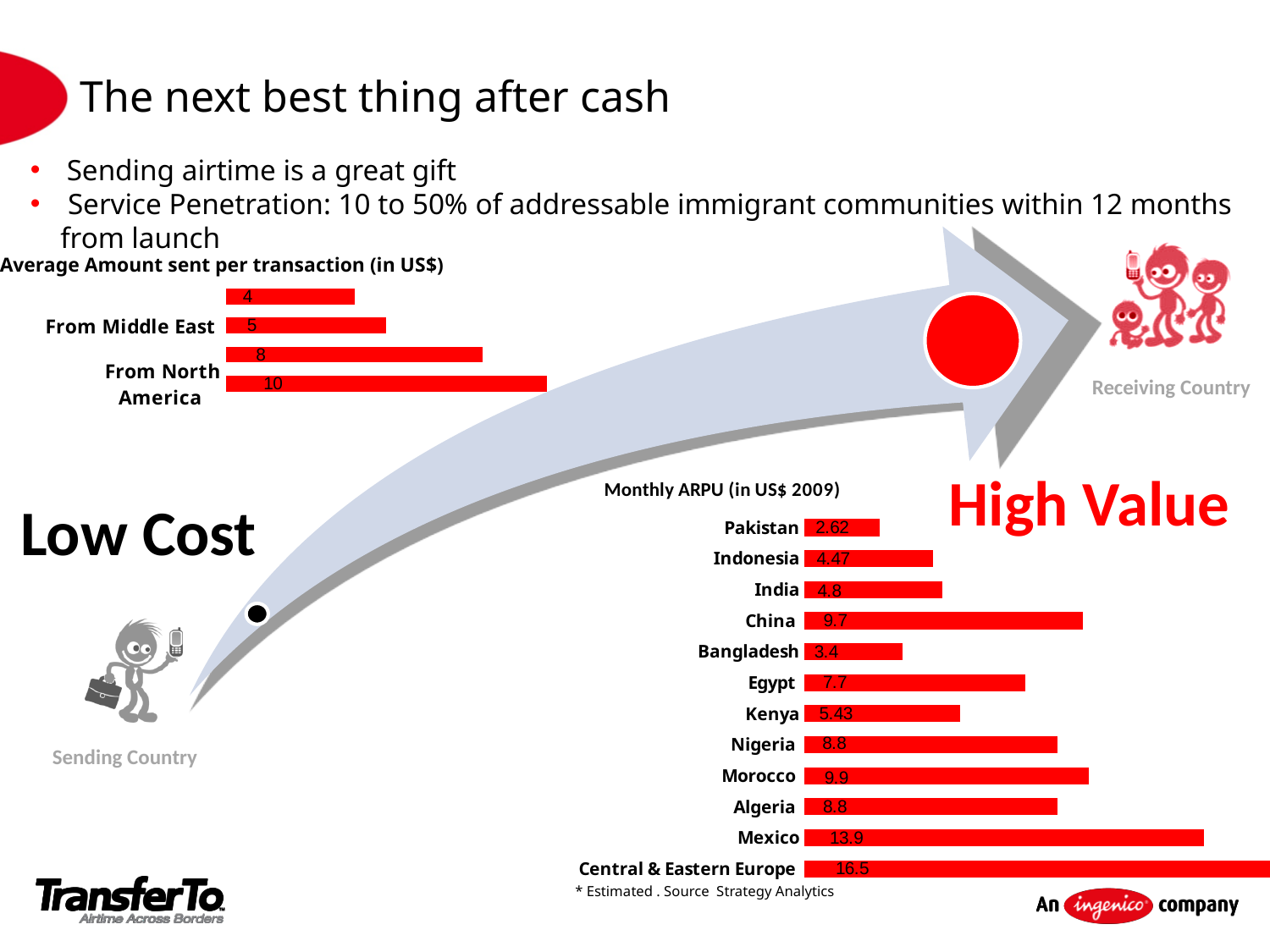
In the Monthly ARPU (in US$ 2009) chart, what is the value for Pakistan? 2.62 In the Monthly ARPU (in US$ 2009) chart, which category has the highest value? Central & Eastern Europe In the Average Amount sent per transaction (in US$) chart, what is the difference between the values for From North America and From Middle East? 5 In the Average Amount sent per transaction (in US$) chart, what is the value for From Middle East? 5 In the Monthly ARPU (in US$ 2009) chart, which is larger, the value for Egypt or the value for Kenya? Egypt What kind of chart is the Monthly ARPU (in US$ 2009) chart? Bar chart How many categories are shown in the Monthly ARPU (in US$ 2009) chart? 12 In the Monthly ARPU (in US$ 2009) chart, what is the difference between the values for Mexico and China? 4.2 In the Monthly ARPU (in US$ 2009) chart, what is the value for Mexico? 13.9 In the Average Amount sent per transaction (in US$) chart, what is the value for From North America? 10 In the Monthly ARPU (in US$ 2009) chart, what is the value for Kenya? 5.43 In the Monthly ARPU (in US$ 2009) chart, which category has the lowest value? Pakistan